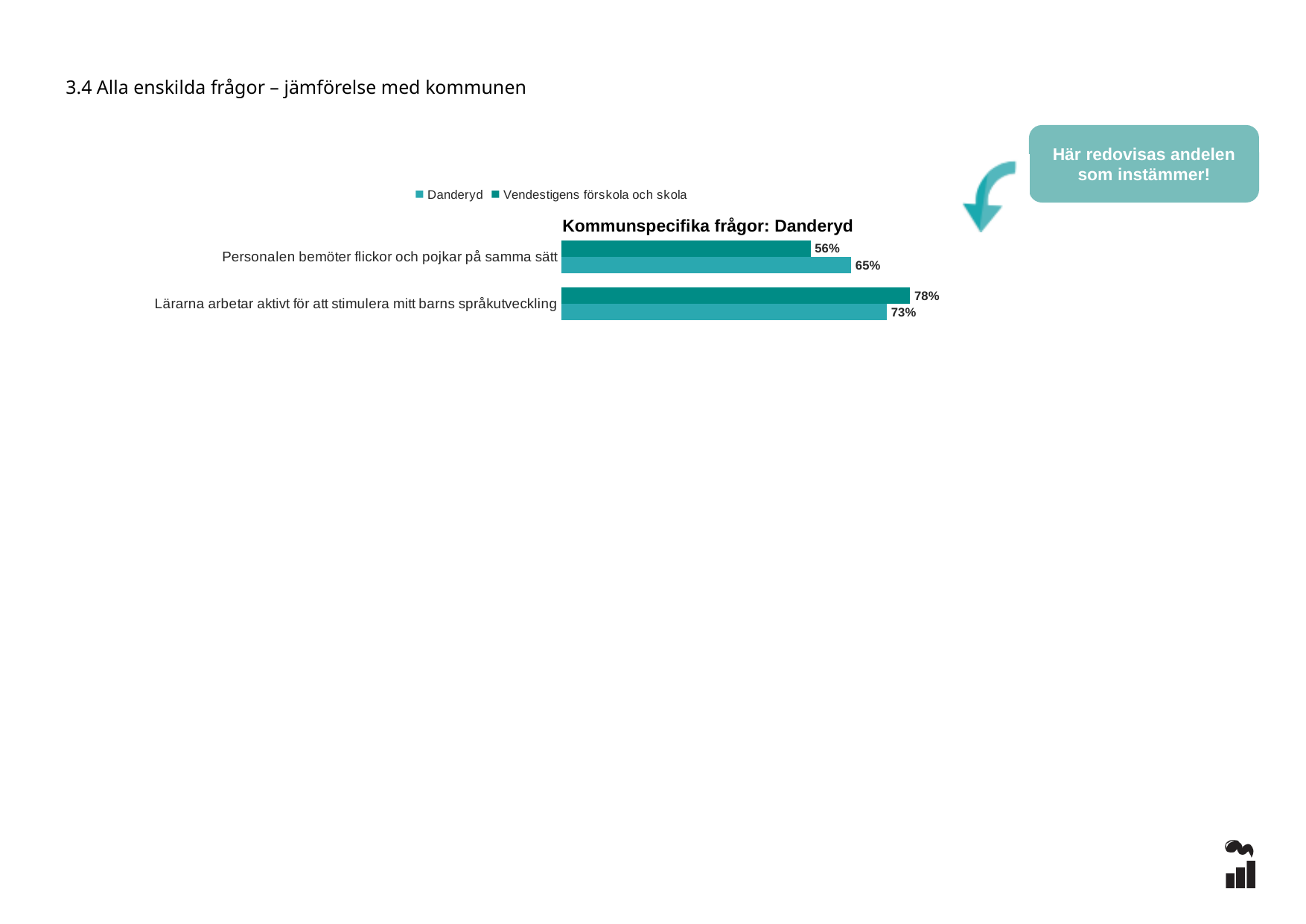
How many series does the legend list? 2 What is the title of the chart? Kommunspecifika frågor: Danderyd What is the difference between Vendestigens förskola och skola and Danderyd for 'Lärarna arbetar aktivt för att stimulera mitt barns språkutveckling'? 5 percentage points What is the value for Danderyd for 'Lärarna arbetar aktivt för att stimulera mitt barns språkutveckling'? 73% For 'Lärarna arbetar aktivt för att stimulera mitt barns språkutveckling', which is higher: Danderyd or Vendestigens förskola och skola? Vendestigens förskola och skola What is the value for Vendestigens förskola och skola for 'Lärarna arbetar aktivt för att stimulera mitt barns språkutveckling'? 78% What is the value for Danderyd for 'Personalen bemöter flickor och pojkar på samma sätt'? 65% What type of chart is shown on the slide? Bar chart Which bar in the chart has the lowest value? Vendestigens förskola och skola for 'Personalen bemöter flickor och pojkar på samma sätt' (56%) What is the difference between Danderyd and Vendestigens förskola och skola for 'Personalen bemöter flickor och pojkar på samma sätt'? 9 percentage points How many categories (questions) are shown in the chart? 2 What is the value for Vendestigens förskola och skola for 'Personalen bemöter flickor och pojkar på samma sätt'? 56%